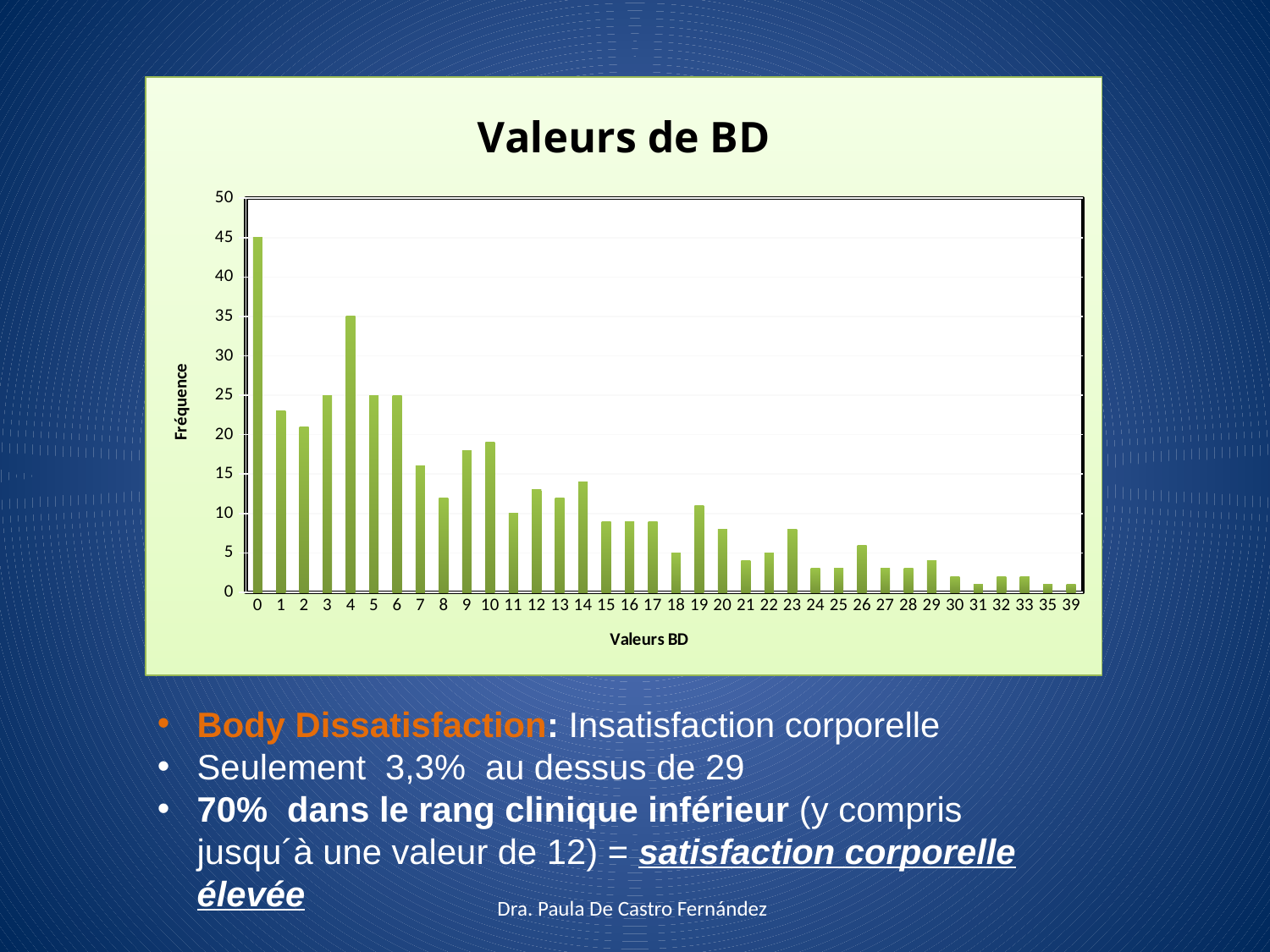
What is the title of the chart? Valeurs de BD Do the frequencies generally rise or fall as the BD value increases along the x axis? fall What is the frequency for the BD value 4? 35 Which has a higher frequency, BD value 3 or BD value 4? 4 Is the frequency for BD value 20 greater or less than 10? less What is the difference between the frequencies for BD values 0 and 4? 10 What is the frequency for the BD value 11? 10 What kind of chart is shown on the slide? bar chart Is the frequency for BD value 1 greater or less than 20? greater What is the label of the vertical axis? Fréquence What is the frequency for the BD value 0? 45 Which BD value has the highest frequency? 0